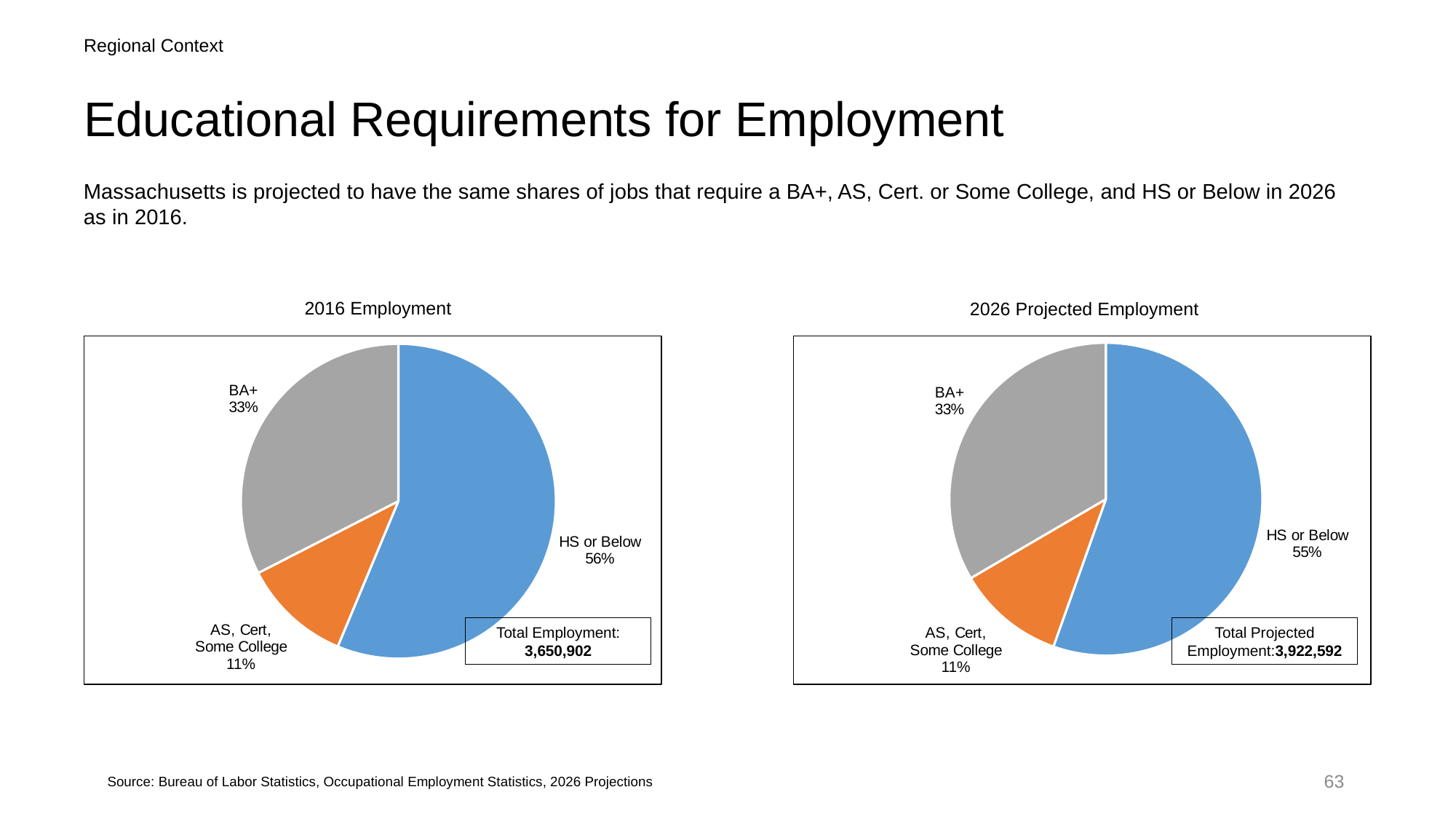
In the 2026 Projected Employment chart, which category has the smallest share? AS, Cert, Some College In the 2016 Employment chart, what share of jobs require HS or Below? 56% In the 2026 Projected Employment chart, what share of jobs require HS or Below? 55% What type of chart is the 2026 Projected Employment chart? Pie chart In the 2026 Projected Employment chart, which is larger: the BA+ share or the AS, Cert, Some College share? BA+ In the 2016 Employment chart, what share of jobs require a BA+? 33% How many categories does the 2016 Employment pie chart show? 3 In the 2026 Projected Employment chart, what share of jobs require AS, Cert, Some College? 11% In the 2016 Employment chart, what is the difference in percentage points between the HS or Below share and the BA+ share? 23 What total employment figure is shown in the 2016 Employment chart? 3,650,902 What total projected employment figure is shown in the 2026 Projected Employment chart? 3,922,592 In the 2016 Employment chart, which category has the largest share? HS or Below